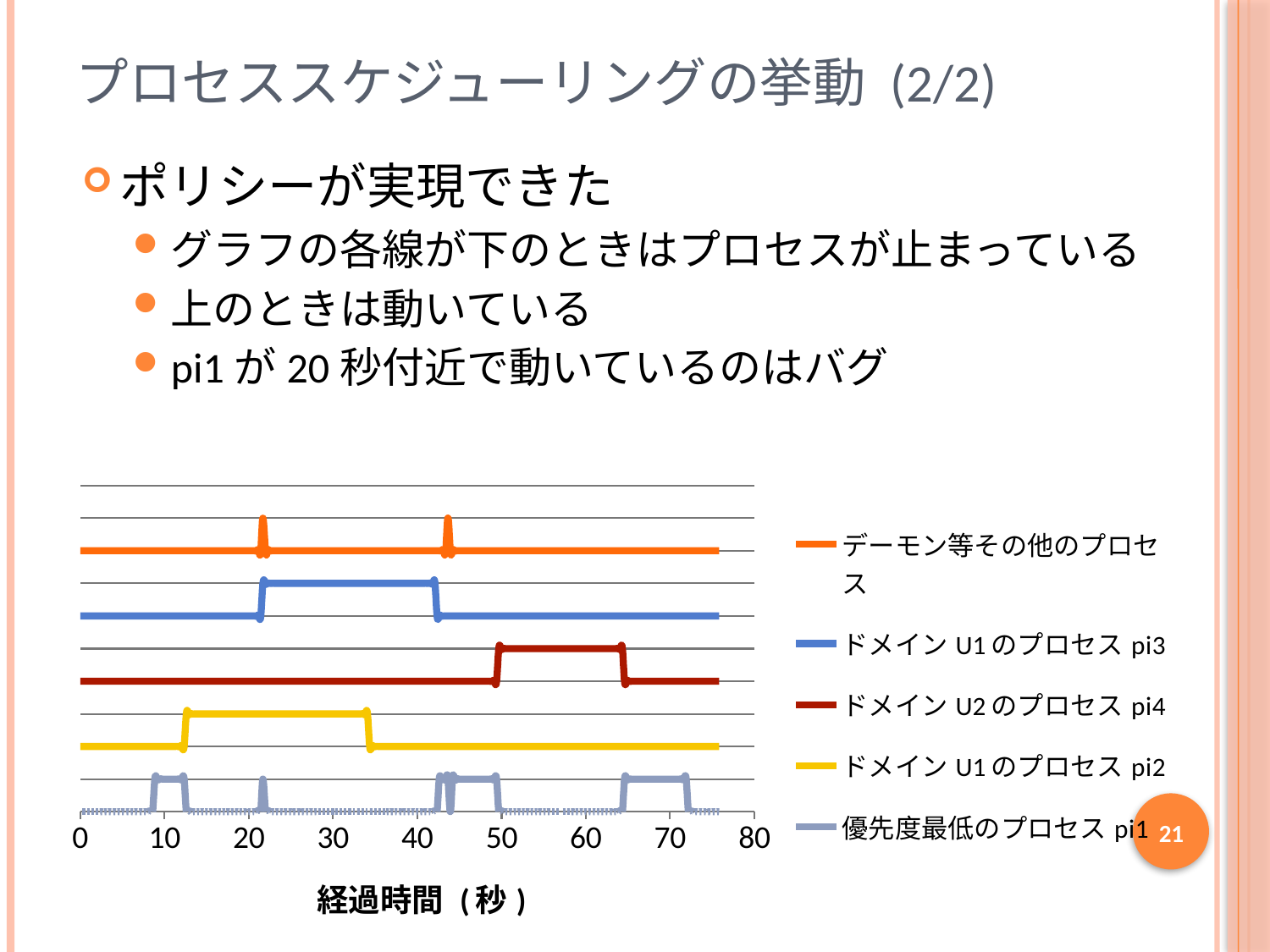
What is the label of the chart's x axis? 経過時間（秒） How many tick labels are shown along the chart's x axis? 9 What kind of chart is shown on the slide? line chart What is the largest value shown on the chart's x axis? 80 Which series in the legend is drawn in blue? ドメイン U1 のプロセス pi3 How many series does the chart's legend list? 5